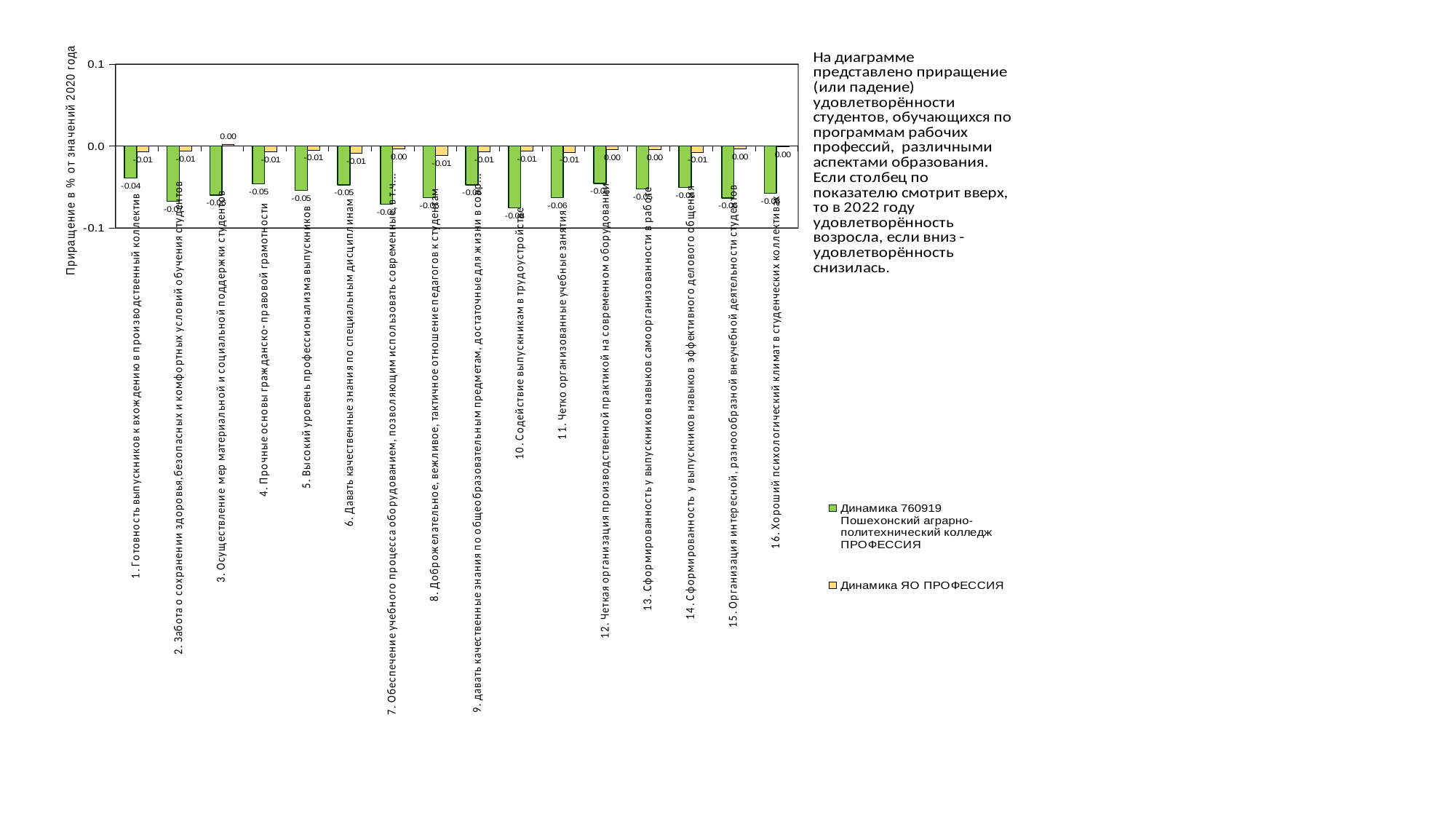
What is the value of the 'Динамика 760919 Пошехонский аграрно-политехнический колледж ПРОФЕССИЯ' series for category 11 (Четко организованные учебные занятия)? -0.06 What is the value of the 'Динамика ЯО ПРОФЕССИЯ' series for category 1 (Готовность выпускников к вхождению в производственный коллектив)? -0.01 How many categories are plotted along the x axis? 16 What is the value of the 'Динамика ЯО ПРОФЕССИЯ' series for category 3 (Осуществление мер материальной и социальной поддержки студентов)? 0.00 What is the value of the 'Динамика 760919 Пошехонский аграрно-политехнический колледж ПРОФЕССИЯ' series for category 1 (Готовность выпускников к вхождению в производственный коллектив)? -0.04 What kind of chart is shown on the slide? Bar chart Is the 'Динамика 760919 Пошехонский аграрно-политехнический колледж ПРОФЕССИЯ' value for category 10 (Содействие выпускникам в трудоустройстве) greater or less than -0.1? greater For the 'Динамика 760919 Пошехонский аграрно-политехнический колледж ПРОФЕССИЯ' series, which is larger: the value for category 1 or the value for category 11? Category 1 What is the title of the vertical axis? Приращение в % от значений 2020 года What is the value of the 'Динамика 760919 Пошехонский аграрно-политехнический колледж ПРОФЕССИЯ' series for category 4 (Прочные основы гражданско-правовой грамотности)? -0.05 For category 1, what is the difference between the 'Динамика ЯО ПРОФЕССИЯ' value and the 'Динамика 760919 Пошехонский аграрно-политехнический колледж ПРОФЕССИЯ' value? 0.03 How many series does the legend list? 2